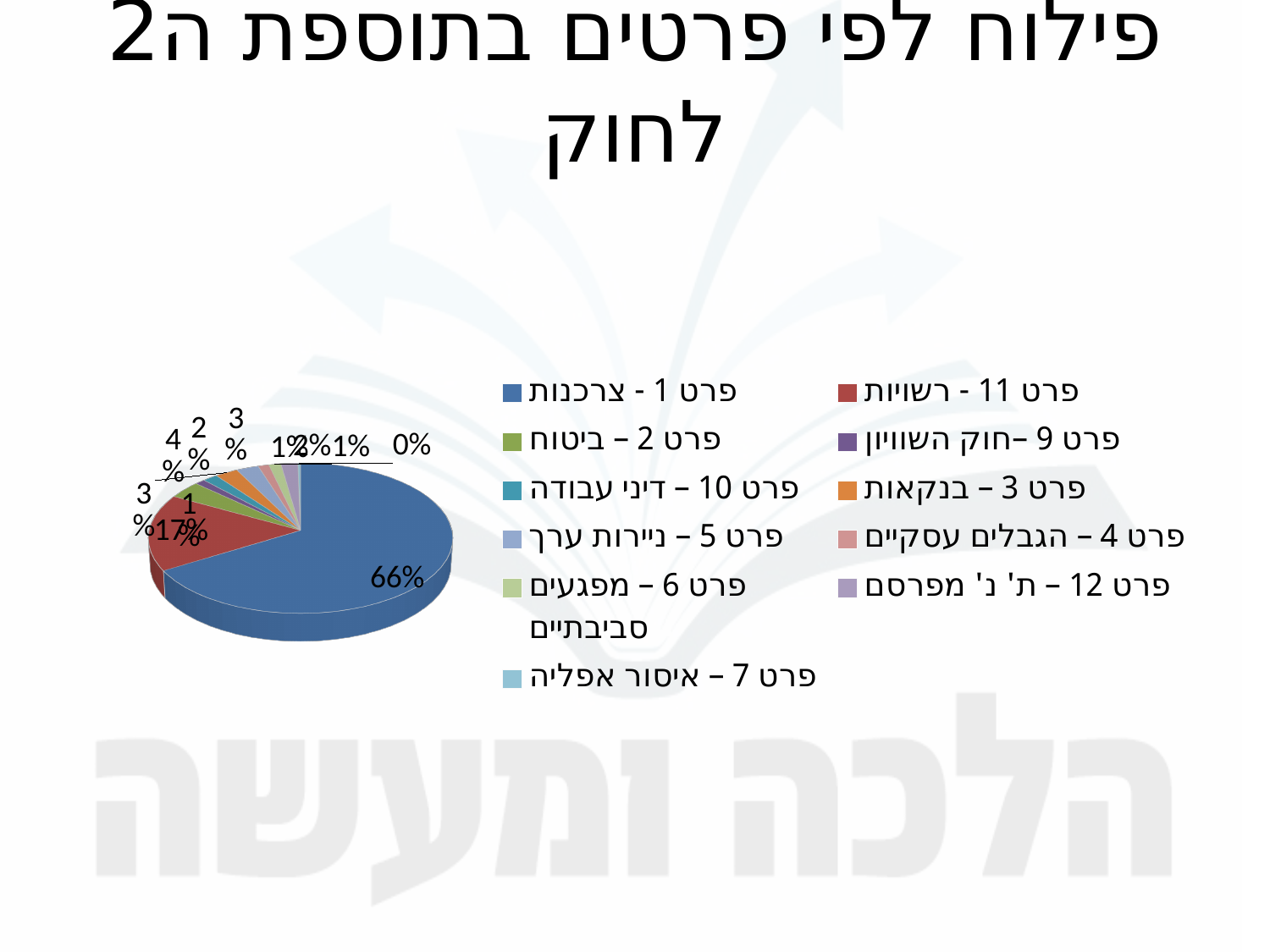
What colour is the largest slice of the pie? Blue What percentage of the pie is the slice for פרט 11 - רשויות? 17% What kind of chart is shown on the slide? Pie chart Which category has the largest slice of the pie? פרט 1 - צרכנות How many categories does the legend of the pie chart list? 11 Which is larger, the slice for פרט 1 - צרכנות or the slice for פרט 11 - רשויות? פרט 1 - צרכנות By how many percentage points does the slice for פרט 1 - צרכנות exceed the slice for פרט 11 - רשויות? 49 Is the share for פרט 1 - צרכנות greater or less than 50%? greater What percentage of the pie is the slice for פרט 1 - צרכנות? 66% What is the title of the chart on the slide? פילוח לפי פרטים בתוספת ה2 לחוק Is the share for פרט 11 - רשויות greater or less than 20%? less